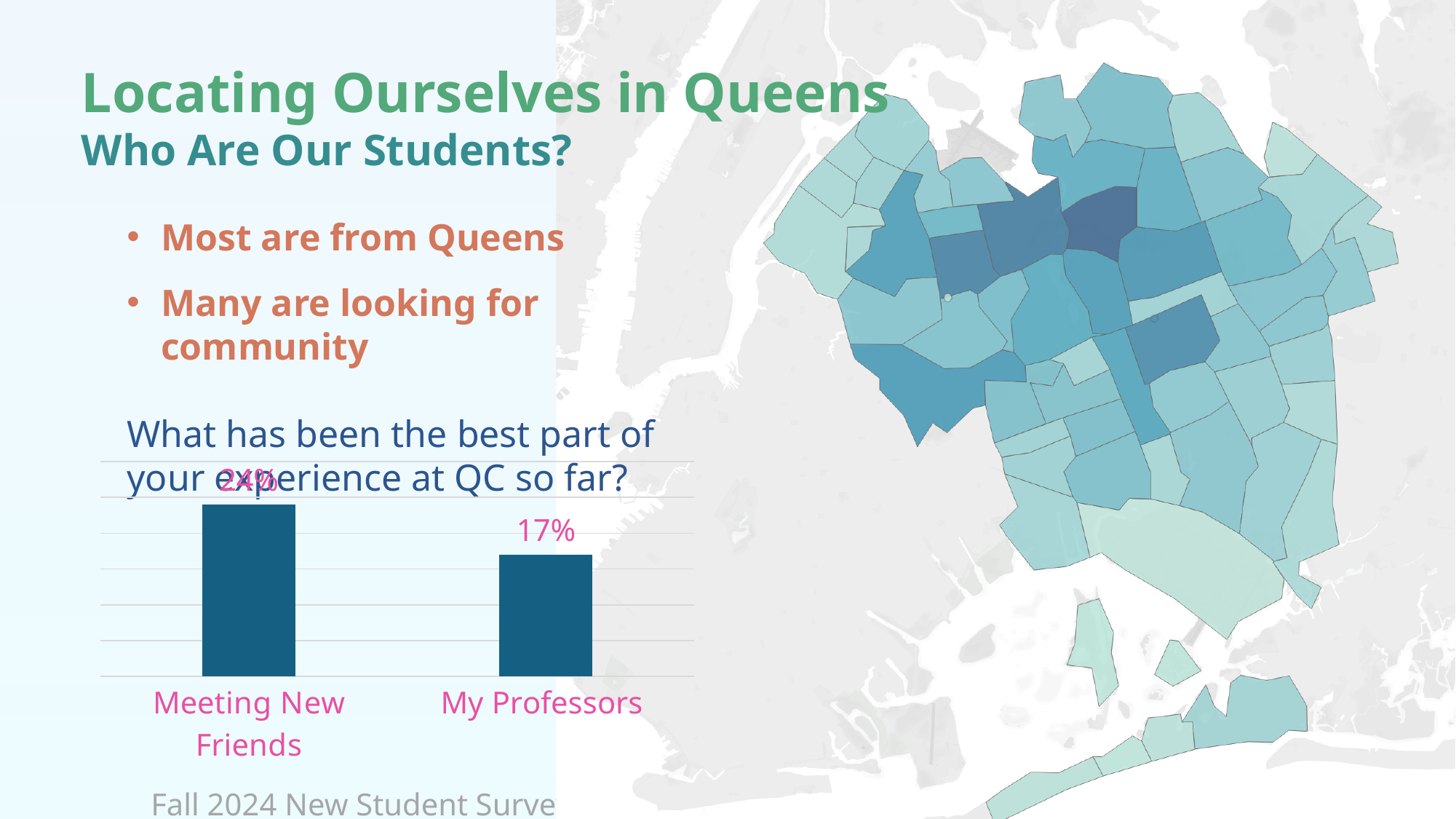
What is the difference between the values for Meeting New Friends and My Professors? 7% What question does the bar chart's title ask? What has been the best part of your experience at QC so far? Which category has the highest value in the bar chart? Meeting New Friends Which is larger in the bar chart: Meeting New Friends or My Professors? Meeting New Friends What colour are the bars in the bar chart? Dark blue Which category has the lowest value in the bar chart? My Professors How many categories are shown in the bar chart? 2 What value is shown for My Professors in the bar chart? 17% What kind of chart is used to show the survey responses? Bar chart What value is shown for Meeting New Friends in the bar chart? 24%